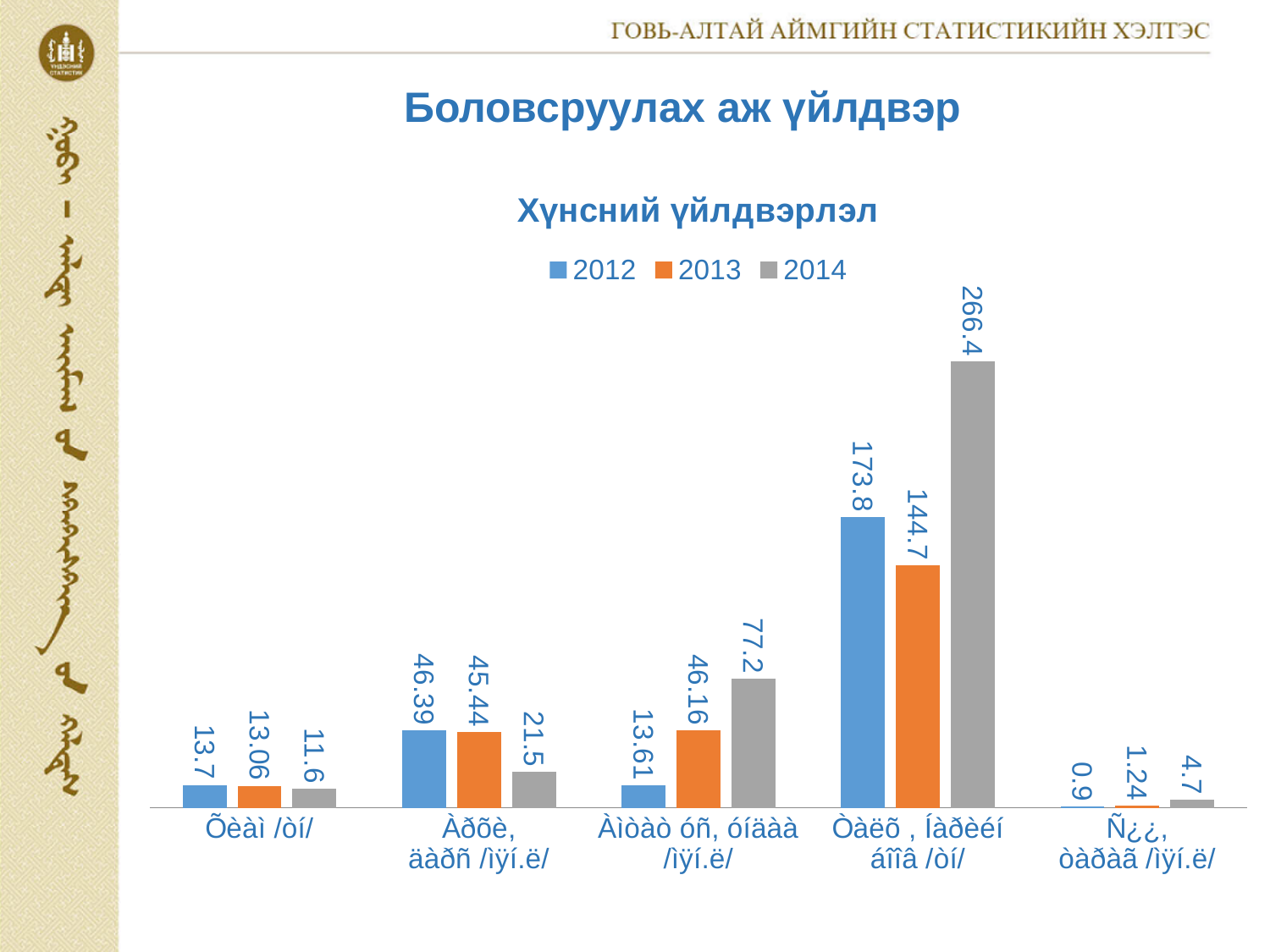
Which category has the lowest 2012 value? Ñ¿¿, òàðàã /ìÿí.ë/ (fifth category) How many categories are shown on the x axis? 5 What is the 2012 value for the third category from the left (Àìòàò óñ, óíäàà /ìÿí.ë/)? 13.61 What is the 2014 value for the fourth category from the left (Òàëõ , Íàðèéí áîîâ /òí/)? 266.4 Which category has the highest 2014 value? Òàëõ , Íàðèéí áîîâ /òí/ (fourth category) What kind of chart is shown on the slide? Bar chart For the second category from the left, which year has the larger value, 2013 or 2014? 2013 How many series does the legend list? 3 For the third category from the left, do the values rise or fall from 2012 to 2014? Rise For the fourth category from the left, how much higher is the 2014 value than the 2013 value? 121.7 What is the 2013 value for the fifth category from the left (Ñ¿¿, òàðàã /ìÿí.ë/)? 1.24 For the third category from the left, what is the difference between the 2014 and 2012 values? 63.59